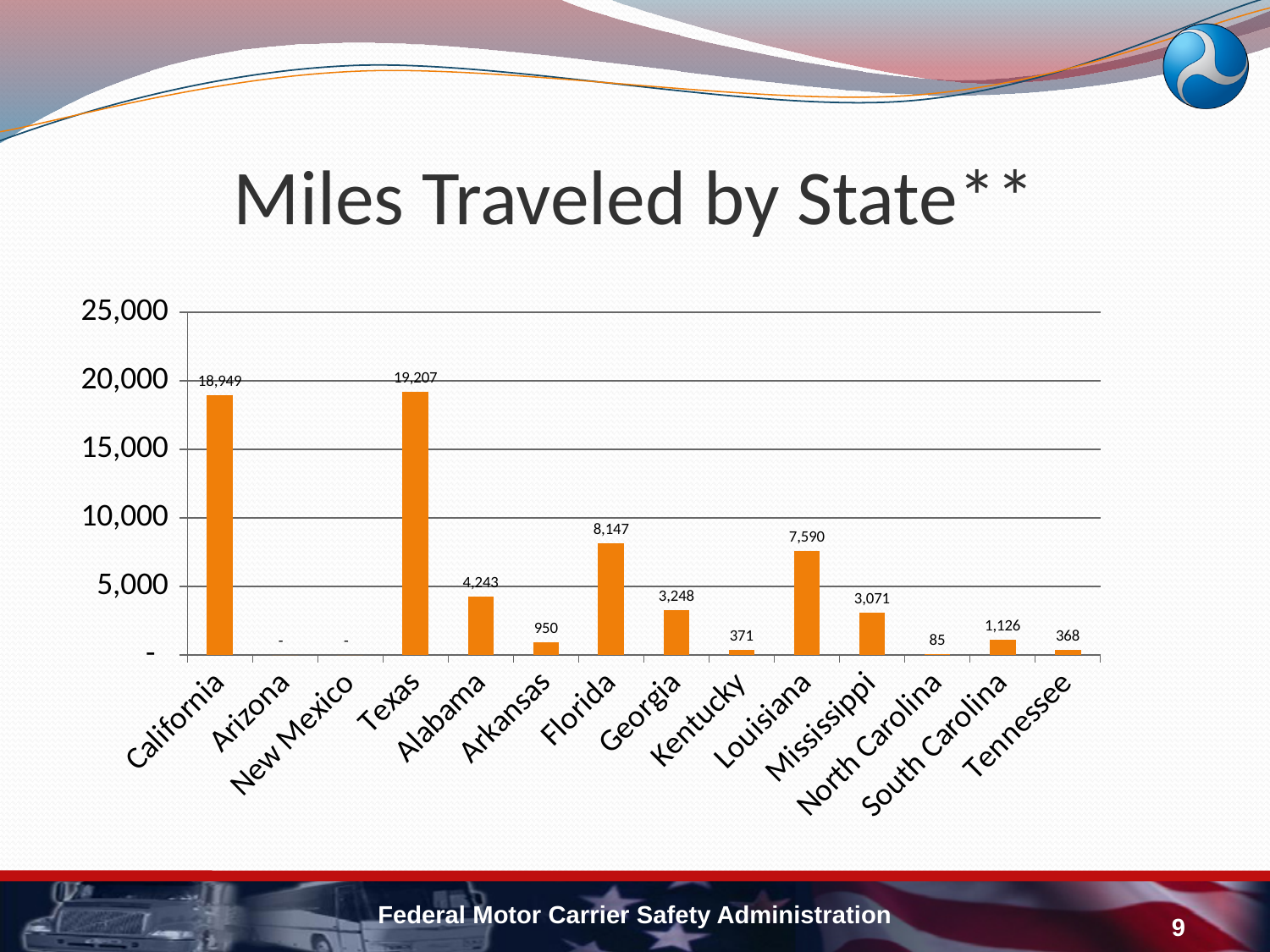
What is the value for California? 18,949 What is the difference between the values for Florida and Louisiana? 557 How many states are shown on the x axis? 14 What is the value for Mississippi? 3,071 Which has a larger value, Alabama or Georgia? Alabama What type of chart is shown on the slide? bar chart What is the title of the chart? Miles Traveled by State** Which state has the highest value? Texas What is the difference between the values for Texas and California? 258 What is the value for Florida? 8,147 What is the value for North Carolina? 85 Is the value for Louisiana greater or less than 5,000? greater